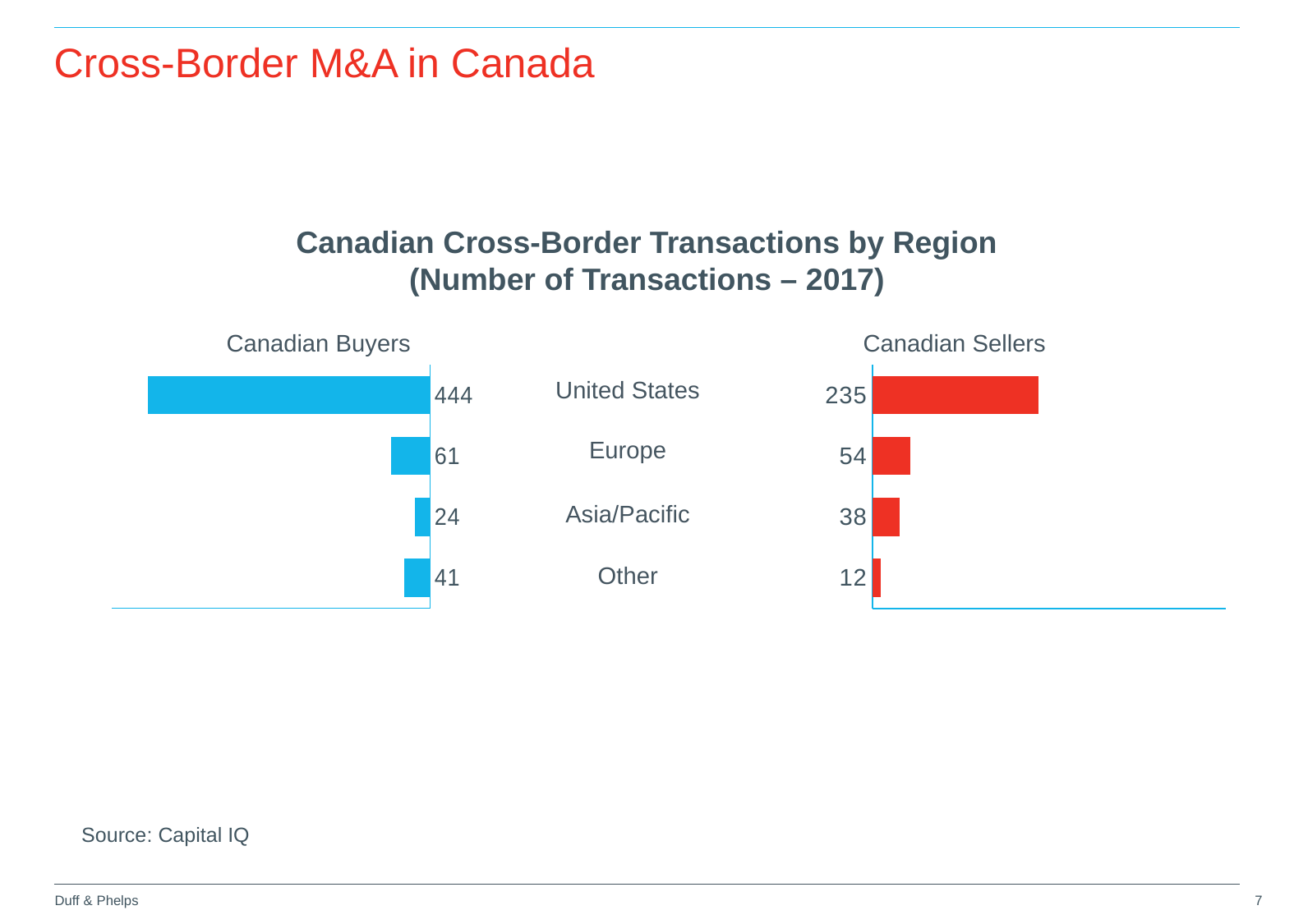
In the Canadian Sellers chart, what is the value for Other? 12 What colour are the bars in the Canadian Sellers chart? Red In the Canadian Sellers chart, what is the value for Europe? 54 In the Canadian Buyers chart, what is the value for Asia/Pacific? 24 In the Canadian Buyers chart, which is larger: Europe or Other? Europe In the Canadian Sellers chart, which region has the lowest value? Other What type of chart is the Canadian Buyers chart? Bar chart In the Canadian Buyers chart, which region has the lowest value? Asia/Pacific How many regions are shown in the Canadian Sellers chart? 4 What is the difference between the United States values in the Canadian Buyers chart and the Canadian Sellers chart? 209 In the Canadian Buyers chart, what is the value for United States? 444 In the Canadian Buyers chart, which region has the highest value? United States